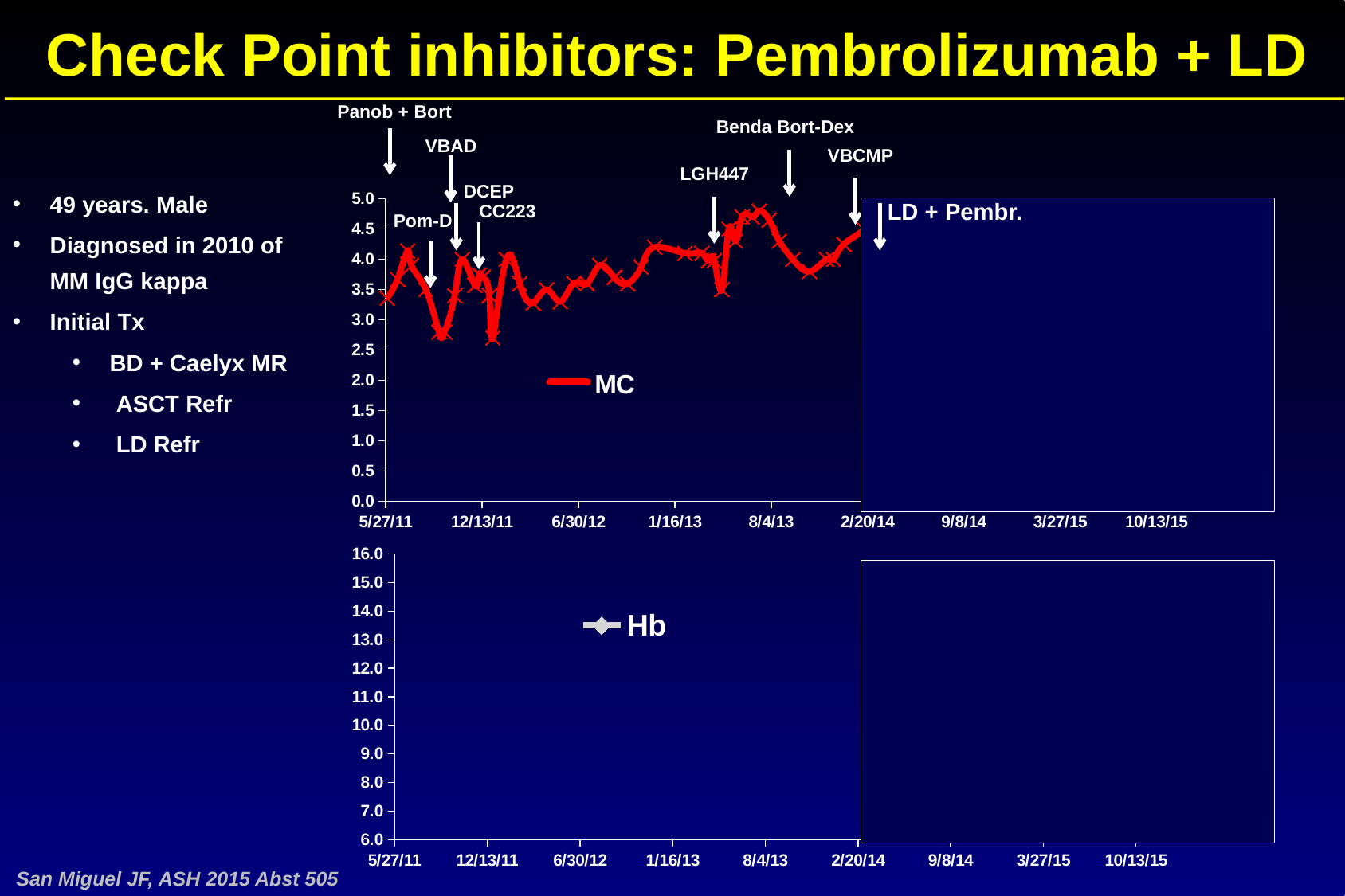
What kind of chart is the top chart (MC)? line chart How many series does the legend of the top chart list? 1 How many date labels are shown on the x axis of the top chart? 9 Which treatment label is placed at the arrow near 2/20/14 in the top chart? LD + Pembr. In the top chart, is the MC value at 5/27/11 greater or less than 3.0? greater In the top chart, is the MC value at 6/30/12 greater or less than 4.0? less What series name appears in the legend of the bottom chart? Hb What is the first date label on the x axis of the bottom chart? 5/27/11 What is the last date label on the x axis of the top chart? 10/13/15 In the top chart, does the MC line overall rise or fall between 1/16/13 and 8/4/13? rise In the top chart, is the lowest MC value shown greater or less than 3.0? less